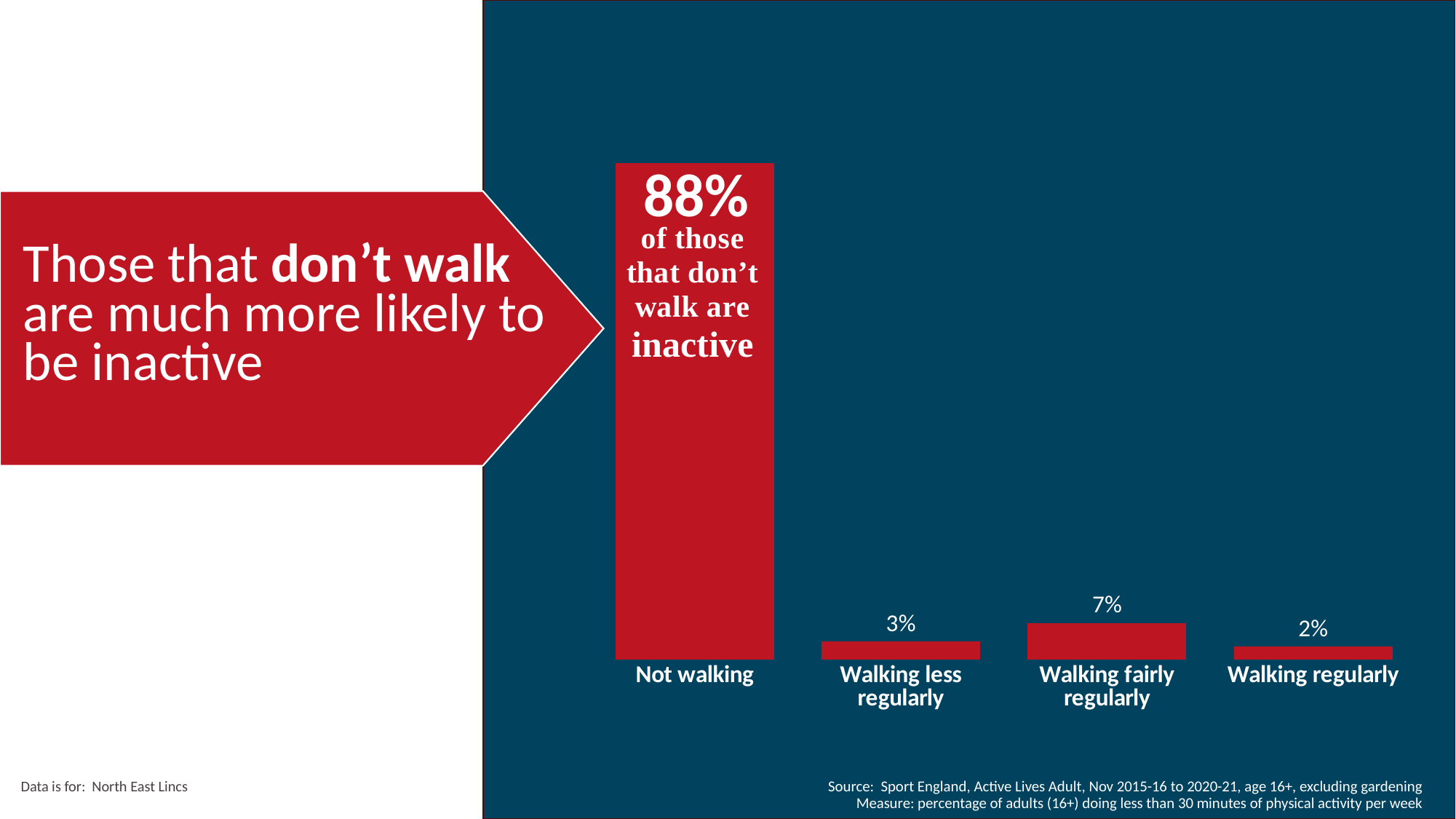
Which is larger, the value for Walking less regularly or Walking regularly? Walking less regularly What is the difference between the values for Walking fairly regularly and Walking less regularly? 4% Which category has the lowest value? Walking regularly Which category has the highest value? Not walking What is the value for Walking regularly? 2% What is the value for Walking fairly regularly? 7% What is the value for Not walking? 88% How many categories are shown in the chart? 4 What colour are the bars in the chart? Red What is the value for Walking less regularly? 3% What kind of chart is shown on the slide? Bar chart What is the difference between the values for Not walking and Walking fairly regularly? 81%